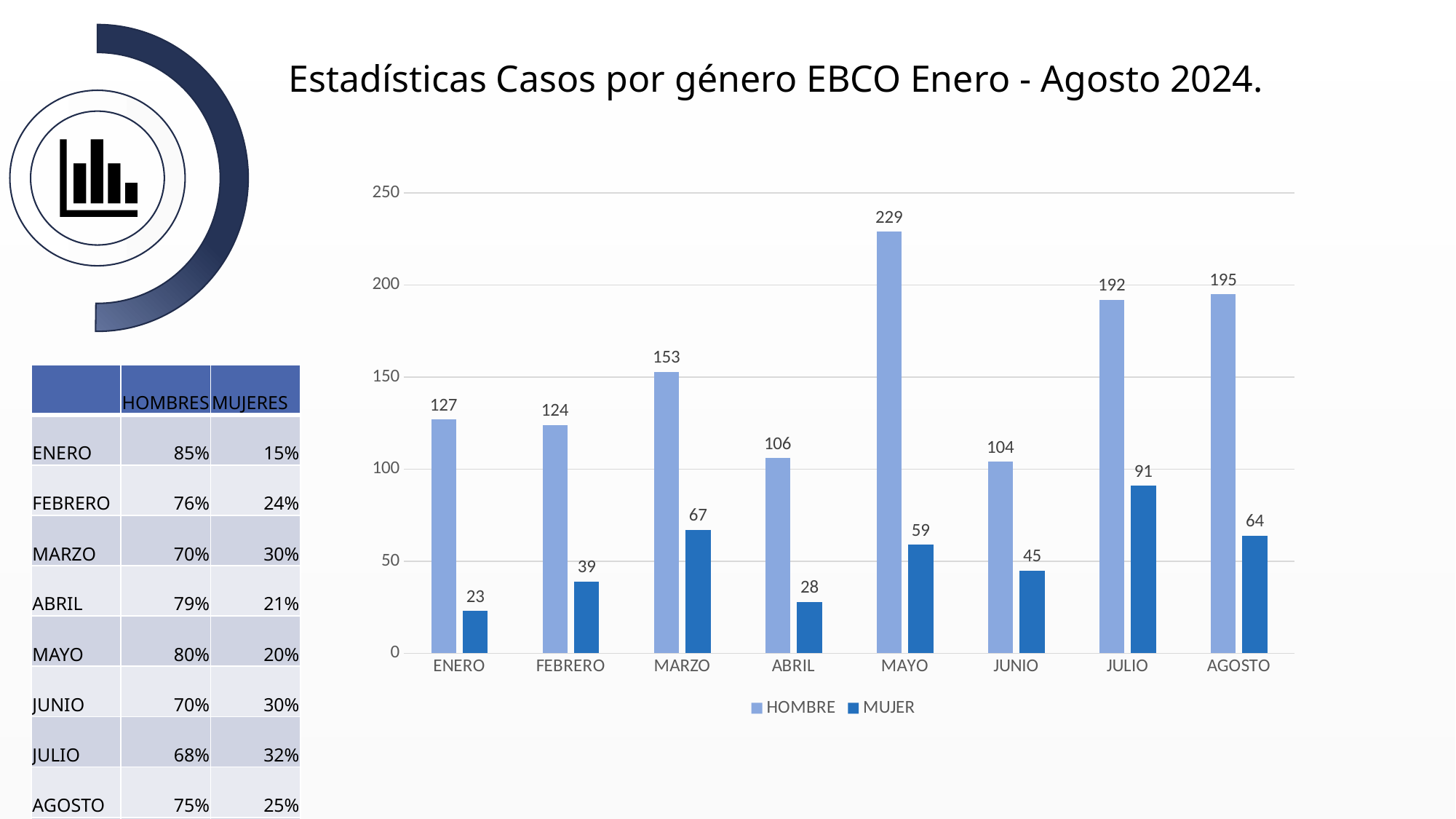
How many series does the chart legend list? 2 How many months are shown on the x axis of the chart? 8 What are the two series names in the chart legend? HOMBRE and MUJER Is the HOMBRE value for ABRIL greater or less than 100? greater What kind of chart is shown on the slide? Bar chart Which is larger, the MUJER value for MARZO or the MUJER value for AGOSTO? MARZO Which month has the highest HOMBRE value? MAYO What is the MUJER value for FEBRERO? 39 What is the HOMBRE value for MAYO? 229 Which month has the lowest MUJER value? ENERO What is the HOMBRE value for AGOSTO? 195 What is the difference between the HOMBRE and MUJER values for JULIO? 101